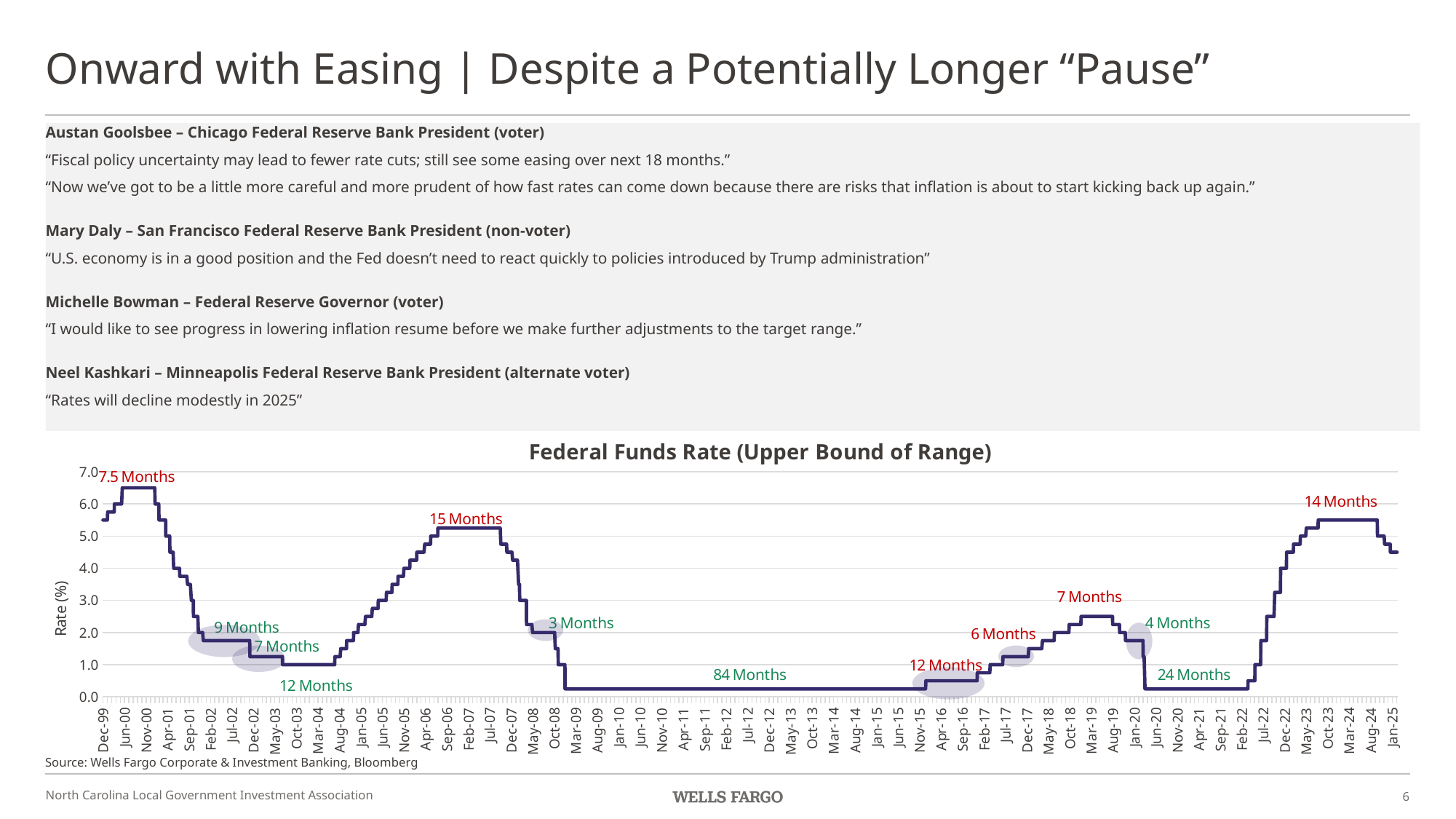
How many months does the annotation at the most recent peak (2023–2024) show? 14 Months Is the Federal Funds Rate at Jan-25 greater or less than 4.0? greater Is the Federal Funds Rate at Jan-15 greater or less than 1.0? less What is the label on the vertical axis of the chart? Rate (%) How many months does the annotation at the 2000 peak of the rate show? 7.5 Months What kind of chart is shown on the slide? Line chart Which pause annotation on the chart shows the shortest duration in months? 3 Months How many months does the annotation at the 2006–2007 peak of the rate show? 15 Months Is the Federal Funds Rate at Jun-00 greater or less than 6.0? greater Which pause annotation on the chart shows the longest duration in months? 84 Months What is the title of the chart? Federal Funds Rate (Upper Bound of Range) Which is larger: the pause duration labelled near Mar-19 or the pause duration labelled near Jan-20? 7 Months